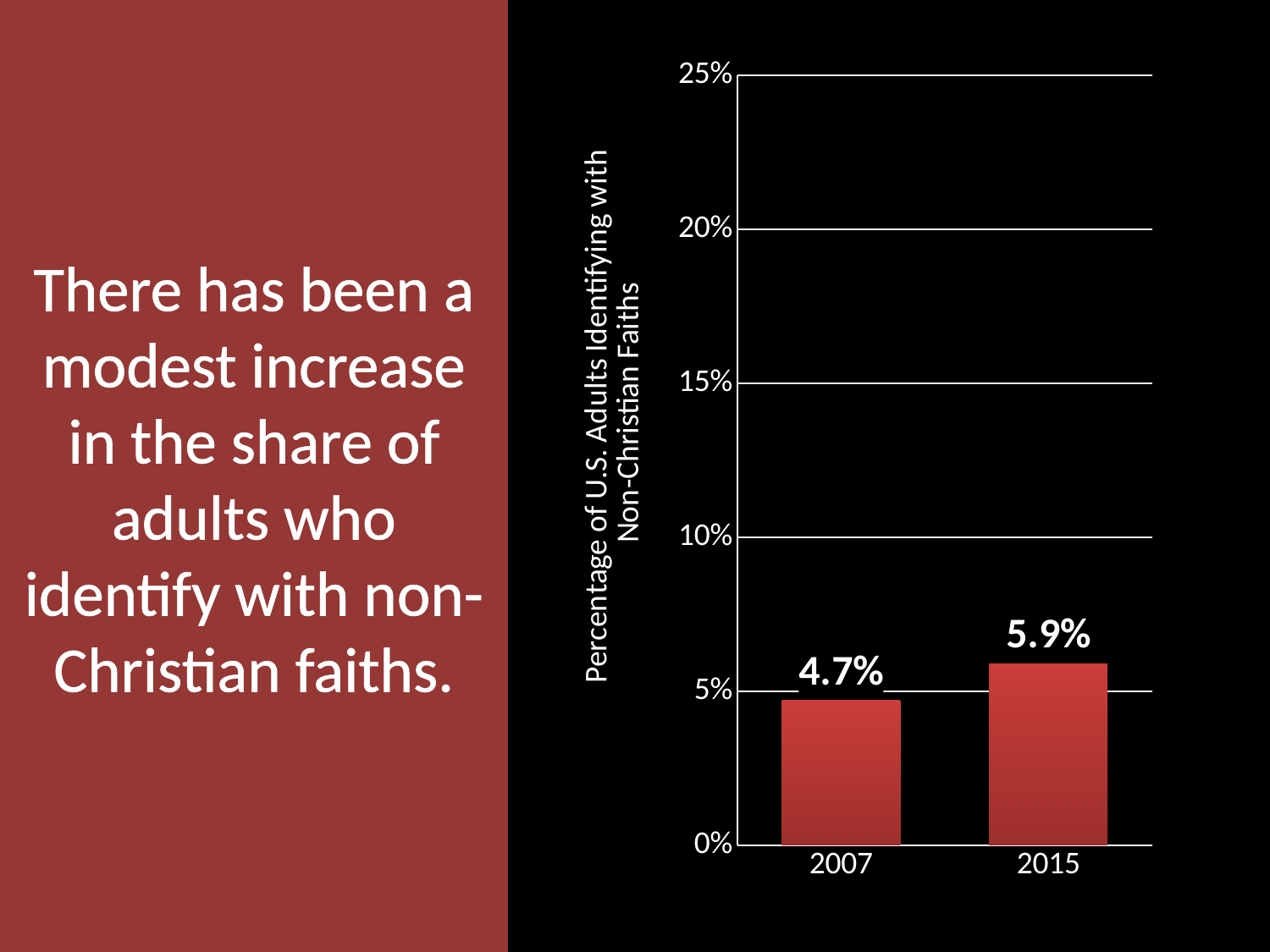
Which year has the lower value? 2007 How many years are shown on the x axis? 2 What is the difference between the values for 2015 and 2007? 1.2% What is the label on the vertical axis? Percentage of U.S. Adults Identifying with Non-Christian Faiths Do the values rise or fall from 2007 to 2015? Rise Is the value for 2015 greater or less than 10%? less Which year has the higher value? 2015 Is the value for 2015 larger than the value for 2007? Yes Is the value for 2007 greater or less than 5%? less What is the value for 2015? 5.9% What kind of chart is shown? Bar chart What is the value for 2007? 4.7%